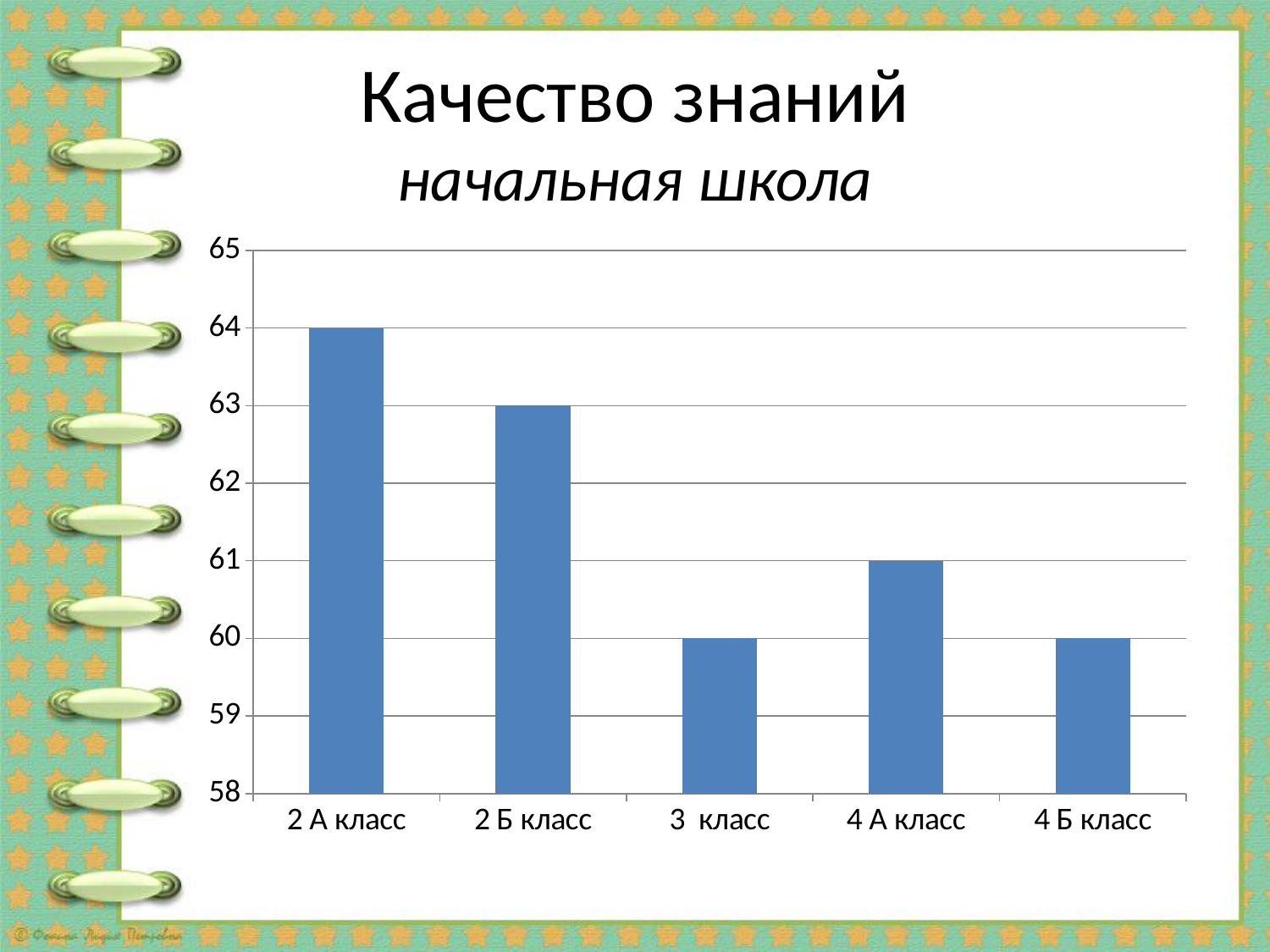
What is the value for 3 класс? 60 What is the difference between the values for 2 А класс and 4 Б класс? 4 What kind of chart is shown on the slide? bar chart Is the value for 2 А класс greater or less than 62? greater What is the title of the slide? Качество знаний начальная школа What is the difference between the values for 2 Б класс and 4 А класс? 2 How many categories are shown on the x axis? 5 What is the value for 2 А класс? 64 Which is larger, the value for 2 Б класс or the value for 4 А класс? 2 Б класс Which category has the highest value? 2 А класс What is the value for 2 Б класс? 63 What is the value for 4 А класс? 61